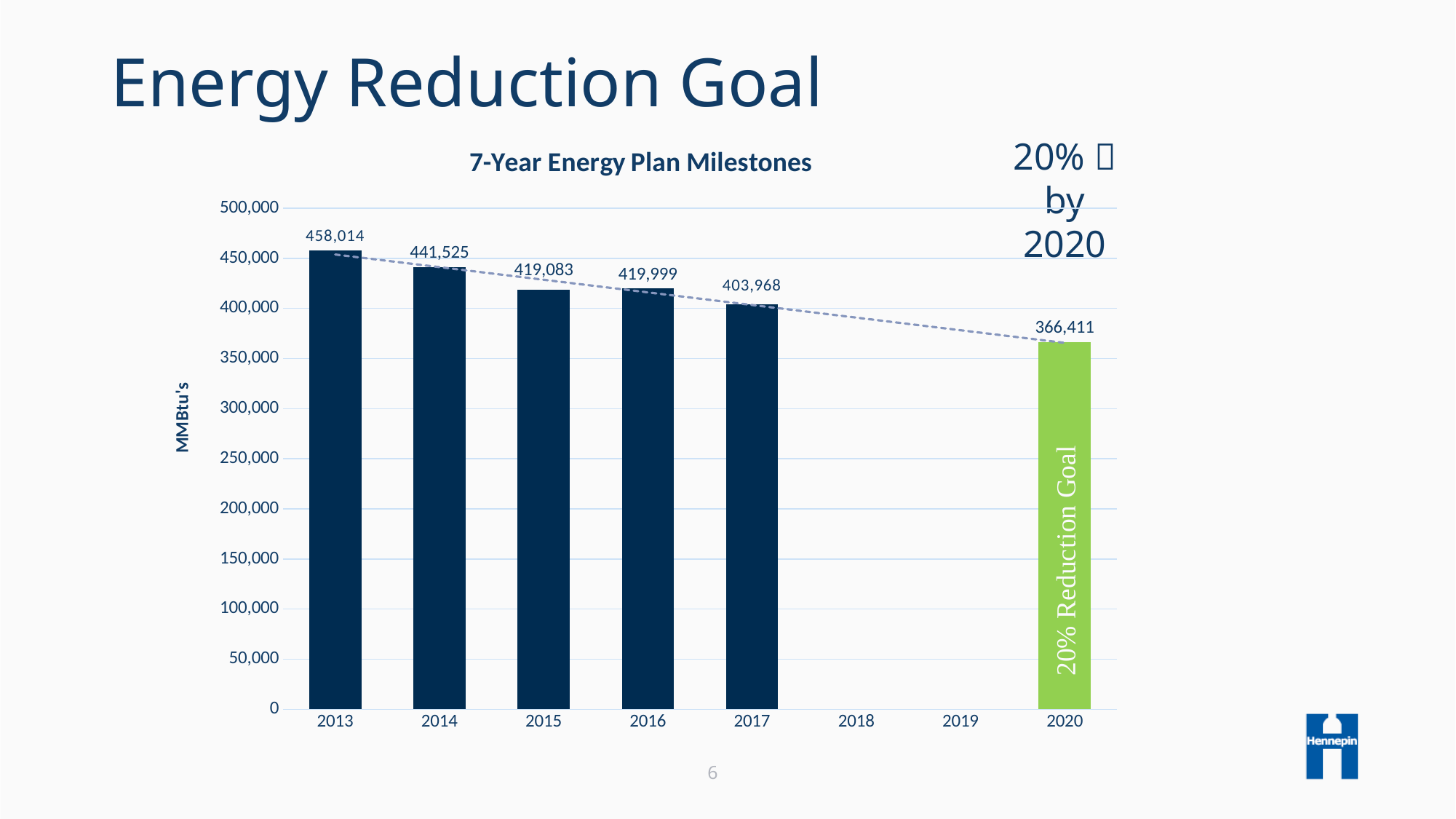
What is the label on the vertical axis of the chart? MMBtu's What is the difference between the 2013 value and the 2014 value? 16,489 Which is larger, the value for 2014 or the value for 2017? 2014 What is the value shown for the 2020 goal bar? 366,411 What is the difference between the 2017 value and the 2020 goal value? 37,557 What is the value for 2013 in the 7-Year Energy Plan Milestones chart? 458,014 Is the value for 2020 greater or less than 400,000? less Which year has the lowest value in the chart? 2020 Which year has the highest value in the chart? 2013 What kind of chart is shown on the slide? Bar chart What is the value for 2017 in the 7-Year Energy Plan Milestones chart? 403,968 How many bars are plotted in the chart? 6